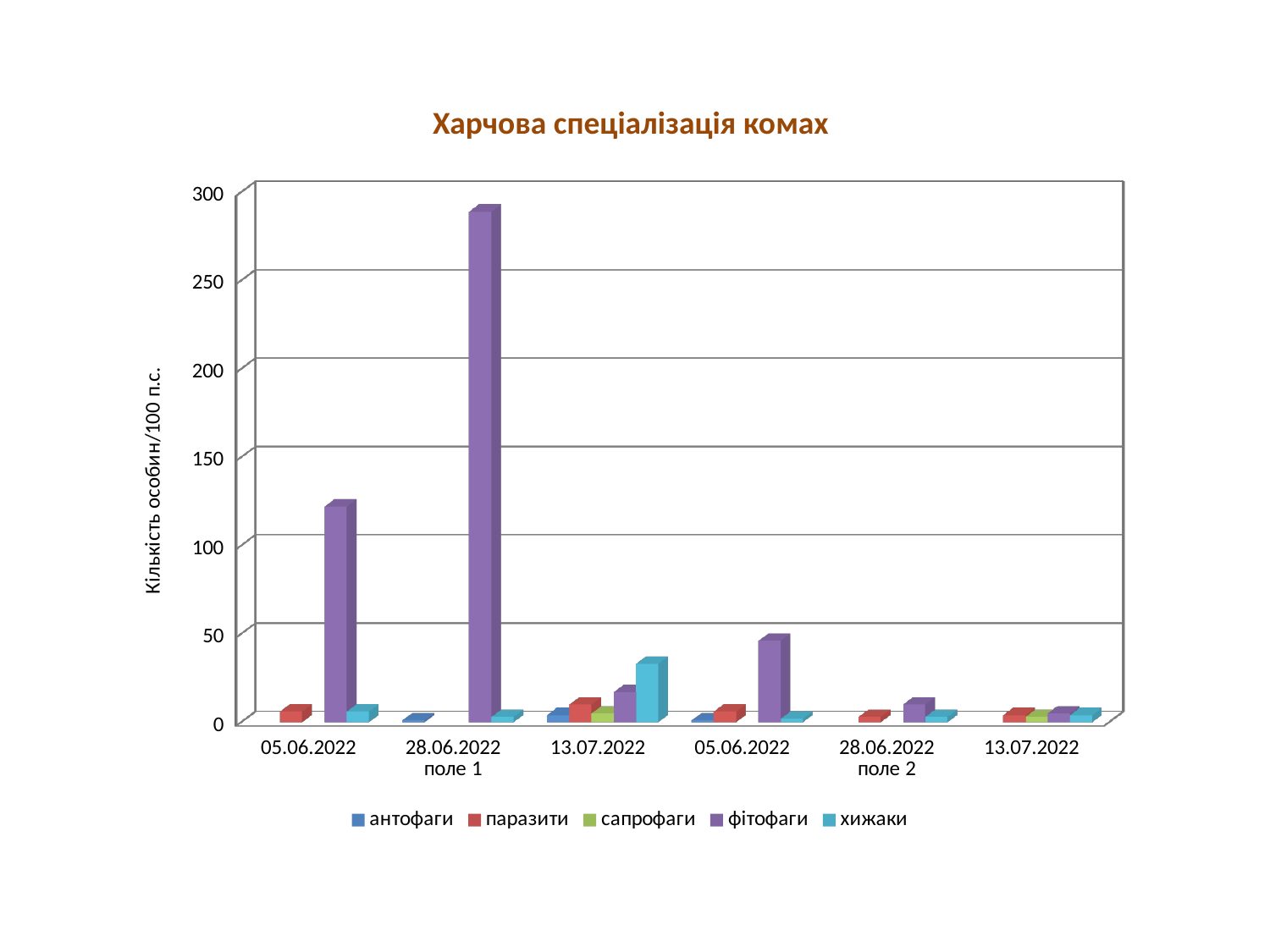
How many date categories are shown along the x axis? 6 On 13.07.2022 (поле 1), which is larger: фітофаги or хижаки? хижаки How many series does the legend list? 5 Is the value for фітофаги on 05.06.2022 (поле 1) greater or less than 100? greater What is the title of the chart? Харчова спеціалізація комах Is the value for фітофаги on 28.06.2022 (поле 1) greater or less than 250? greater Is the value for фітофаги on 05.06.2022 (поле 2) greater or less than 100? less What kind of chart is shown on the slide? bar chart What is the label of the vertical axis? Кількість особин/100 п.с. Do the values for фітофаги rise or fall across the three dates of поле 2? fall Which is larger for фітофаги: 05.06.2022 on поле 1 or 05.06.2022 on поле 2? 05.06.2022 on поле 1 For which date and field is the value for фітофаги the highest? 28.06.2022, поле 1